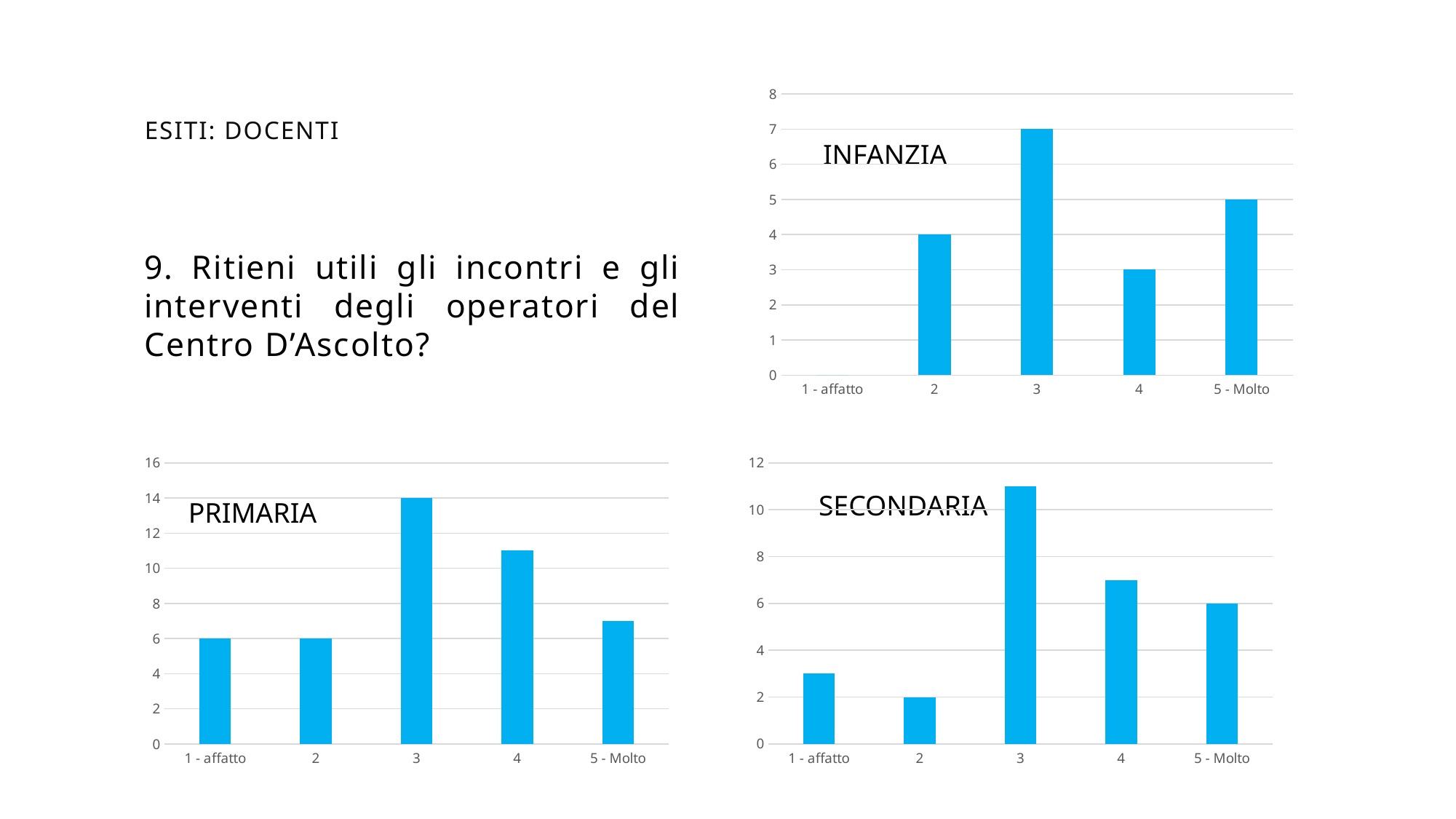
In the PRIMARIA chart, is the value for category 4 greater or less than 10? greater In the SECONDARIA chart, which category has the lowest value? 2 How many categories are shown on the x axis of the SECONDARIA chart? 5 In the PRIMARIA chart, what is the value for 1 - affatto? 6 In the INFANZIA chart, which is larger, the value for 4 or the value for 5 - Molto? 5 - Molto In the SECONDARIA chart, is the value for category 3 greater or less than 10? greater In the INFANZIA chart, what is the value for category 2? 4 In the PRIMARIA chart, what is the value for category 3? 14 In the INFANZIA chart, what is the difference between the values for category 3 and category 2? 3 In the INFANZIA chart, what is the value for category 3? 7 In the SECONDARIA chart, what is the value for 5 - Molto? 6 In the PRIMARIA chart, which category has the highest value? 3